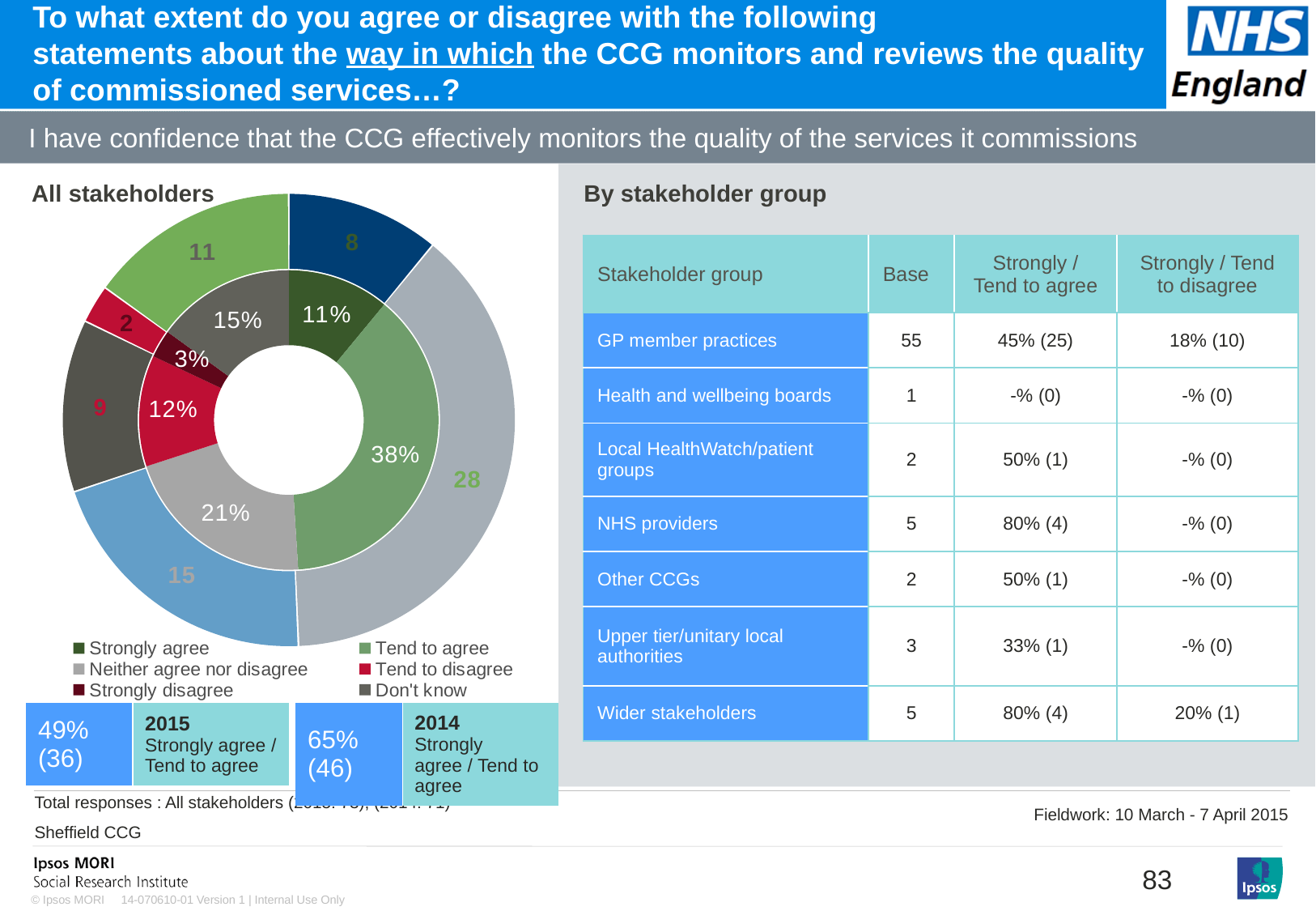
What percentage of all stakeholders 'Strongly disagree' in the doughnut chart? 3% What percentage of all stakeholders 'Tend to agree' in the doughnut chart? 38% Which response category has the largest share in the 'All stakeholders' doughnut chart? Tend to agree In the outer ring of the doughnut chart, how many respondents 'Tend to agree'? 28 In the outer ring of the doughnut chart, how many respondents 'Neither agree nor disagree'? 15 What percentage of all stakeholders 'Strongly agree' in the doughnut chart? 11% What percentage of all stakeholders answered 'Don't know' in the doughnut chart? 15% What is the difference in percentage points between 'Tend to agree' and 'Neither agree nor disagree' in the doughnut chart? 17 Which response category has the smallest share in the 'All stakeholders' doughnut chart? Strongly disagree How many response categories does the legend of the doughnut chart list? 6 What type of chart is used for 'All stakeholders'? Doughnut chart Which is larger in the doughnut chart: 'Tend to disagree' or 'Don't know'? Don't know